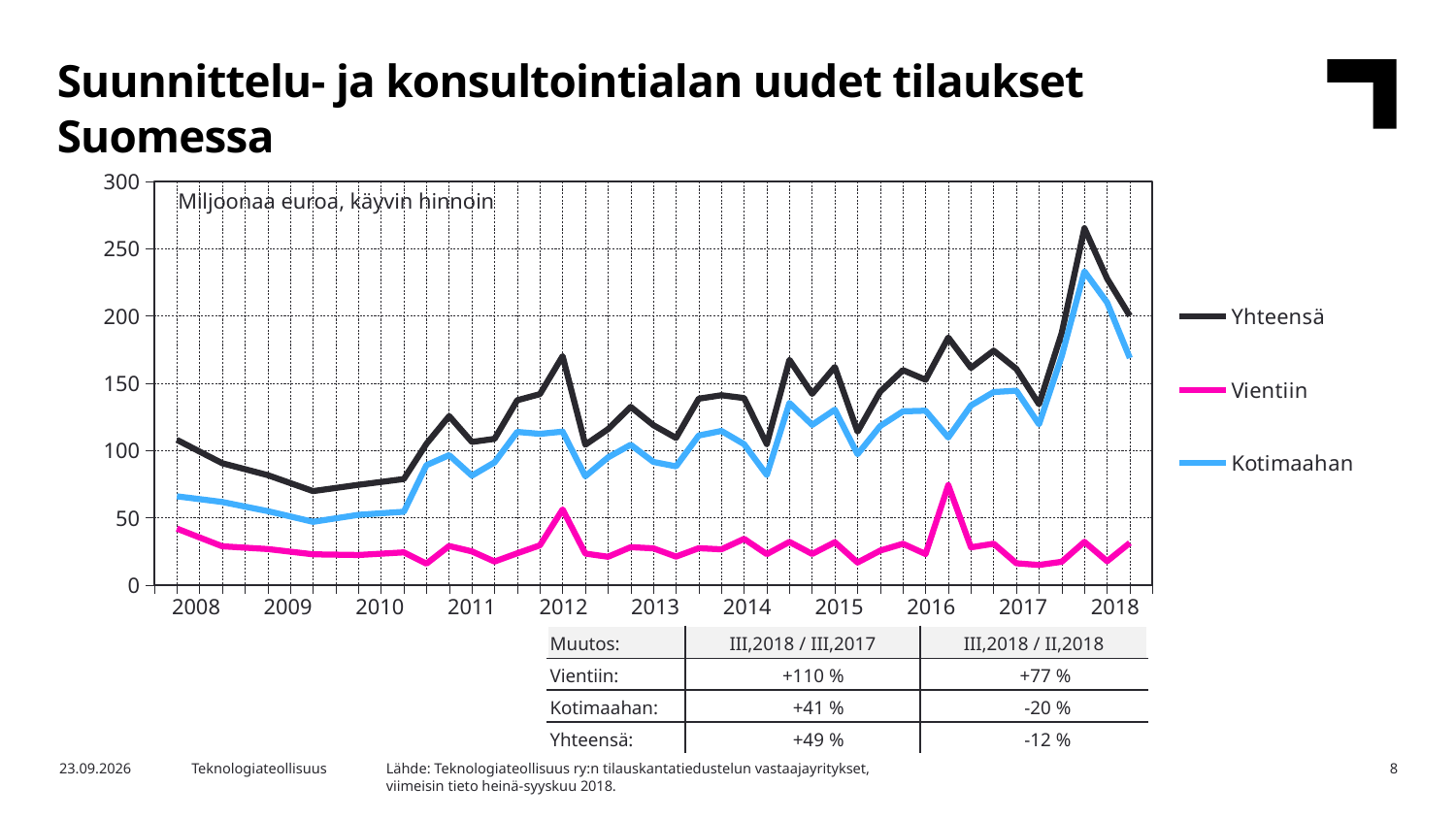
What are the three series named in the chart legend? Yhteensä, Vientiin, Kotimaahan According to the table below the chart, what is the change for Vientiin in III,2018 / III,2017? +110 % What kind of chart is shown on the slide? line chart Is the peak value of the Vientiin line in 2016 greater or less than 50? greater Which series has the highest values throughout the chart? Yhteensä How many series does the chart legend list? 3 Which is larger in 2018: the Kotimaahan value or the Vientiin value? Kotimaahan What unit is stated in the text inside the chart area? Miljoonaa euroa, käyvin hinnoin Is the highest value of the Kotimaahan line greater or less than 200? greater Which series has the lowest values throughout the chart? Vientiin Is the Vientiin line at any point greater or less than 100? less